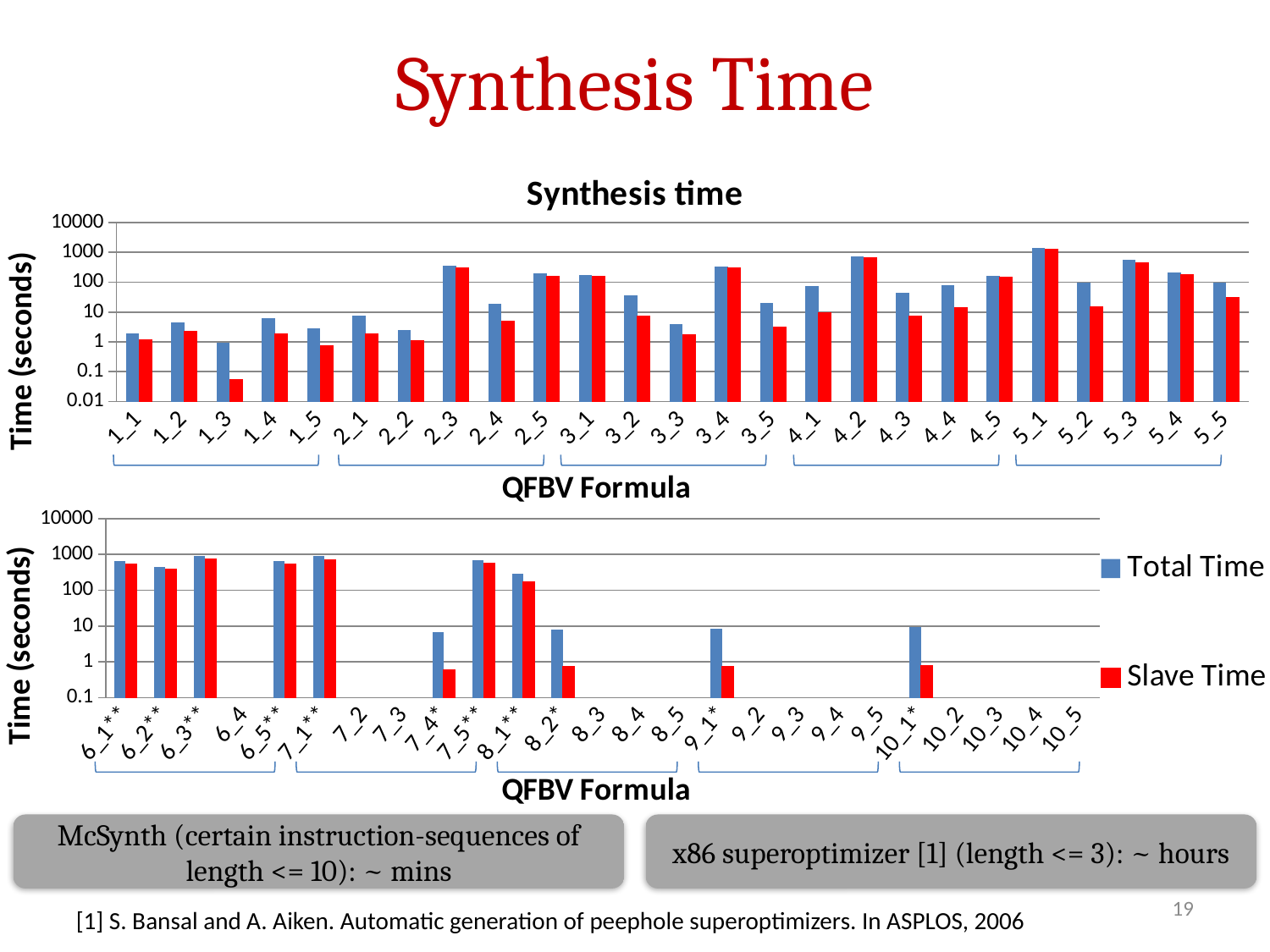
In the top chart, is the Slave Time for 1_3 greater or less than 0.1 seconds? less How many QFBV formula categories are shown on the x axis of the top chart? 25 In the top chart, for formula 4_1, which is larger: Total Time or Slave Time? Total Time What is the label on the y axis of the bottom chart? Time (seconds) In the bottom chart, is the Slave Time for 7_4* greater or less than 1 second? less In the bottom chart, is the Total Time for 8_1* greater or less than 100 seconds? greater In the top chart, which QFBV formula has the lowest Slave Time? 1_3 What are the two series named in the legend? Total Time and Slave Time How many series does the legend list for the charts? 2 In the top chart, which QFBV formula has the highest Total Time? 5_1 What kind of chart is the top chart titled "Synthesis time"? bar chart